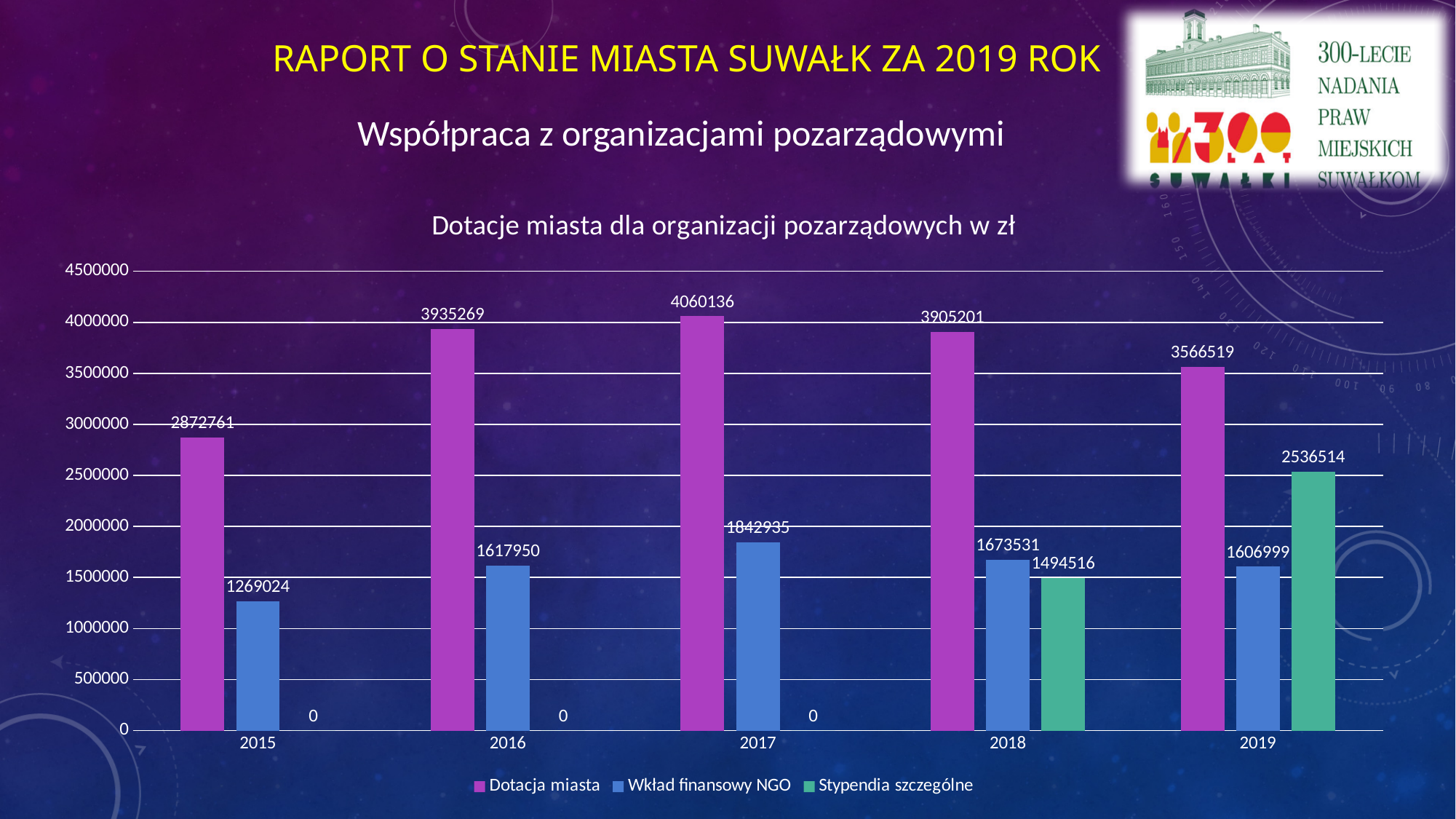
What is the title of the chart? Dotacje miasta dla organizacji pozarządowych w zł What is the difference between Dotacja miasta in 2016 and in 2015? 1062508 Is the value of Dotacja miasta for 2019 greater or less than 3500000? greater In which year is Dotacja miasta the highest? 2017 How many years are shown on the x axis? 5 What kind of chart is shown on the slide? bar chart What is the value of Wkład finansowy NGO for 2015? 1269024 How many series does the legend list? 3 In which year is Dotacja miasta the lowest? 2015 What is the value of Dotacja miasta for 2017? 4060136 What is the value of Stypendia szczególne for 2019? 2536514 Which is larger: Wkład finansowy NGO in 2018 or in 2019? 2018